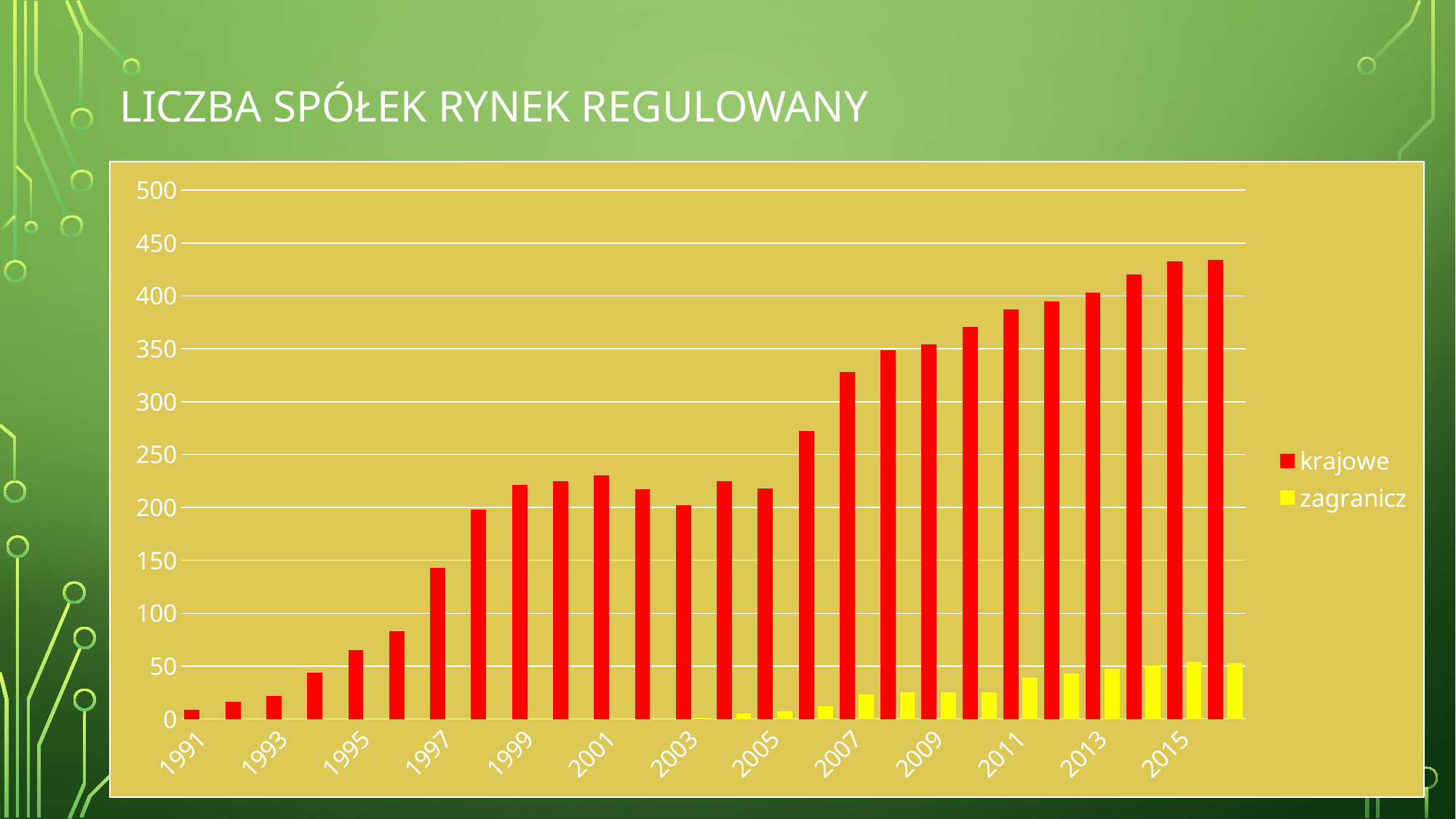
Which year has the lowest value for krajowe? 1991 Does the krajowe series generally rise or fall from 1991 to 2015? rise What kind of chart is shown on the slide? bar chart Is the zagranicz value for 2011 greater or less than 50? less What is the title of the slide? LICZBA SPÓŁEK RYNEK REGULOWANY Is the krajowe value for 1997 greater or less than 150? less What are the two series named in the legend? krajowe and zagranicz Is the krajowe value for 2007 greater or less than 300? greater Which is larger, the krajowe value for 2001 or for 2003? 2001 How many series does the legend list? 2